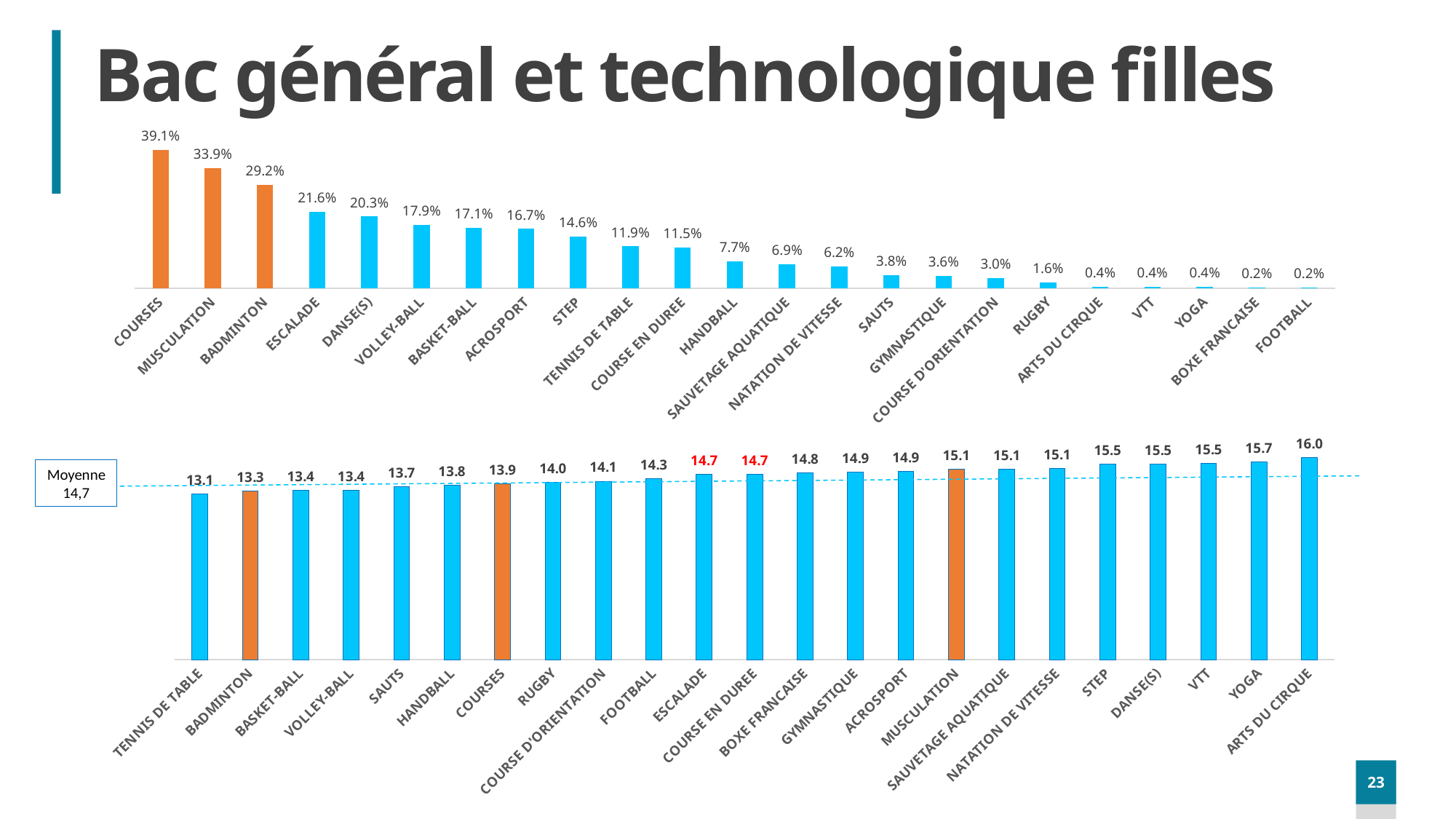
In the top chart, what is the value for COURSES? 39.1% In the bottom chart, which category has the lowest value? TENNIS DE TABLE In the bottom chart, what is the value for ARTS DU CIRQUE? 16.0 In the bottom chart, what is the difference between YOGA and BADMINTON? 2.4 In the top chart, what is the value for HANDBALL? 7.7% In the top chart, which is larger, ESCALADE or DANSE(S)? ESCALADE What value does the 'Moyenne' label in the bottom chart show? 14,7 How many categories are shown in the bottom chart? 23 In the top chart, do the values rise or fall from left to right? fall In the bottom chart, what is the value for TENNIS DE TABLE? 13.1 In the top chart, what is the difference between MUSCULATION and BADMINTON? 4.7% In the top chart, which category has the highest value? COURSES